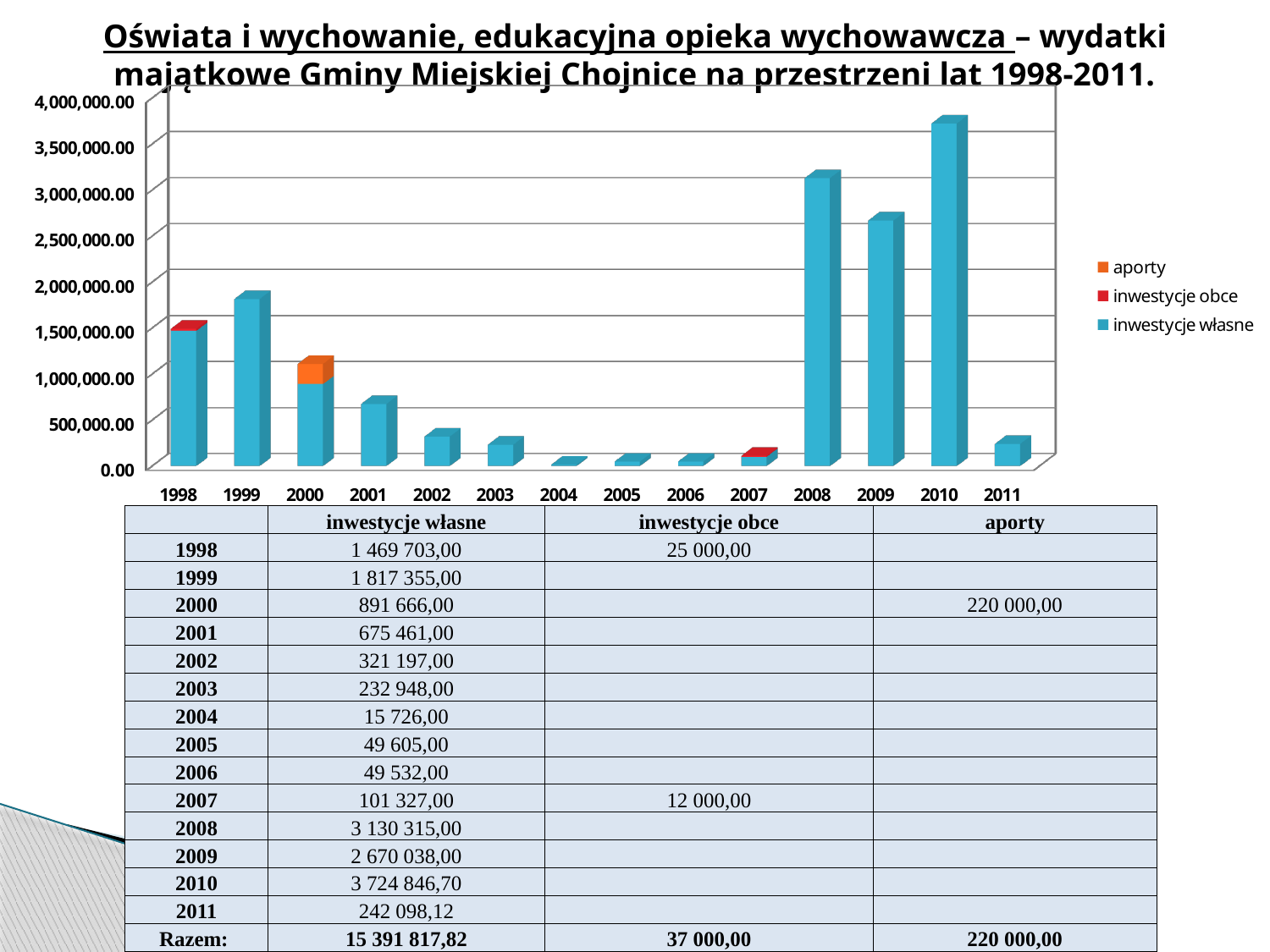
Is the value for 2010 greater or less than 3,500,000.00? greater What is the value of inwestycje własne for 2010? 3 724 846,70 How many years (categories) are shown on the x axis of the chart? 14 Which year has the lowest value of inwestycje własne? 2004 What is the total of the stacked bar for 1998 (inwestycje własne plus inwestycje obce)? 1 494 703,00 What type of chart is shown on the slide? stacked bar chart Which year has a larger value of inwestycje własne, 1998 or 1999? 1999 How many series does the chart legend list? 3 Which year has the highest value of inwestycje własne? 2010 What is the value of aporty for 2000? 220 000,00 What is the difference between inwestycje własne in 2008 and in 2009? 460 277,00 What is the value of inwestycje obce for 2007? 12 000,00